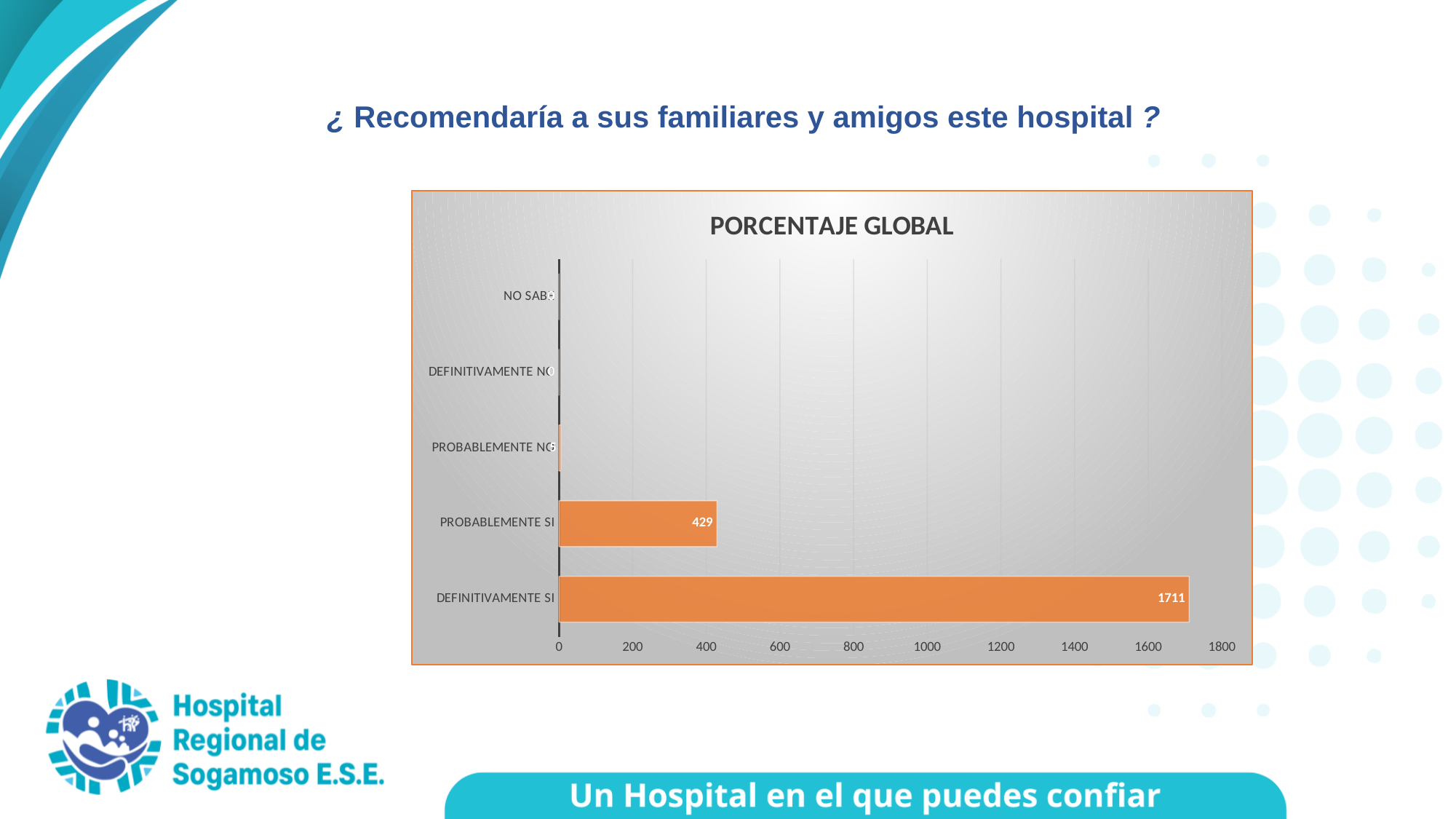
How many categories are shown on the chart? 5 What is the value for PROBABLEMENTE SI? 429 Which category has the highest value? DEFINITIVAMENTE SI What is the title of the chart? PORCENTAJE GLOBAL What is the highest value shown on the horizontal axis? 1800 Is the value for DEFINITIVAMENTE SI greater or less than 1600? greater What is the value for DEFINITIVAMENTE SI? 1711 What kind of chart is shown on the slide? bar chart Is the value for PROBABLEMENTE NO greater or less than 200? less Is the value for PROBABLEMENTE SI greater or less than 600? less What is the difference between the values for DEFINITIVAMENTE SI and PROBABLEMENTE SI? 1282 Which is larger, the value for PROBABLEMENTE SI or the value for PROBABLEMENTE NO? PROBABLEMENTE SI